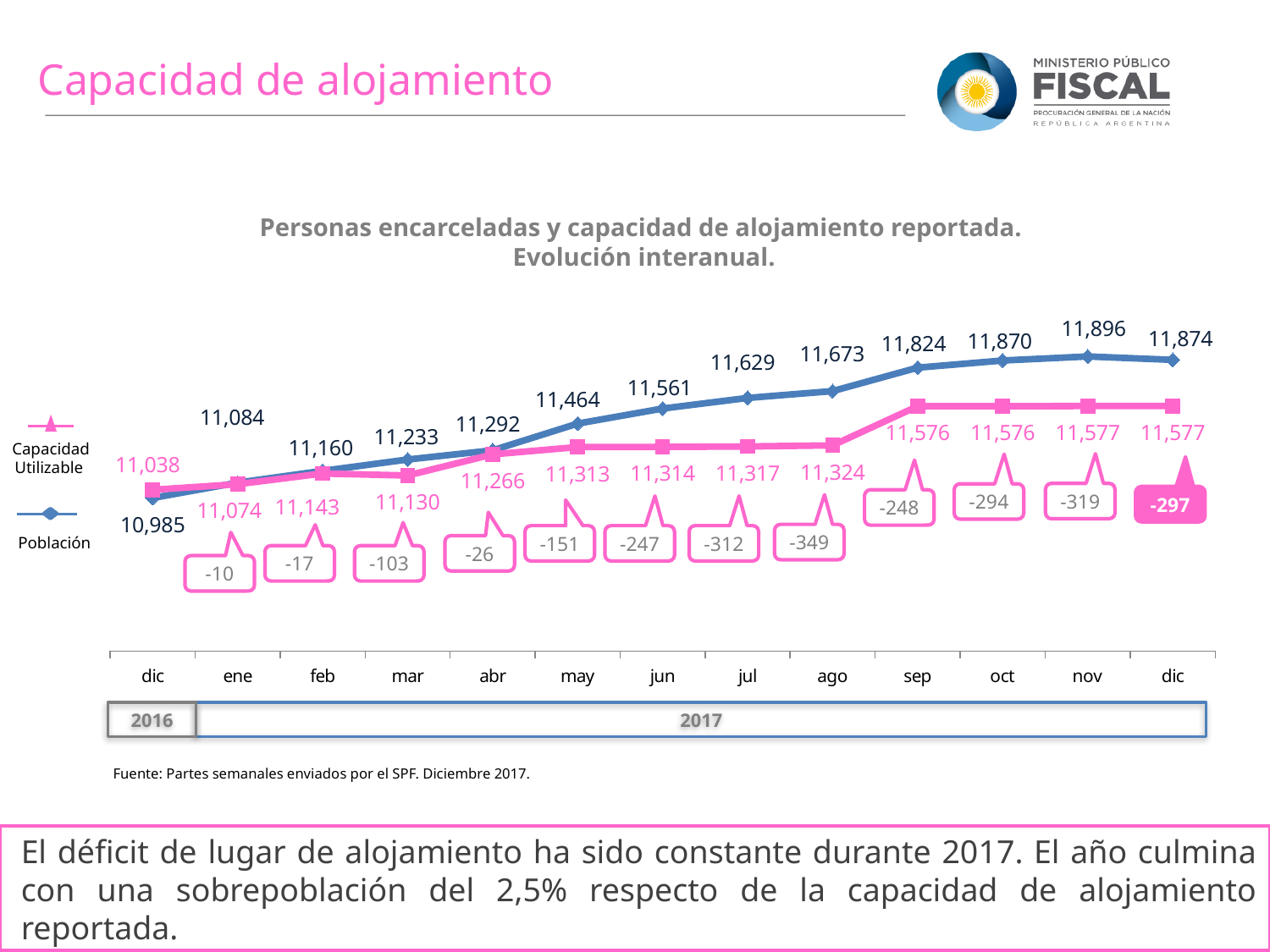
In which month is the Población series at its lowest value? dic 2016 What is the Capacidad Utilizable value for sep 2017? 11,576 What is the Capacidad Utilizable value for dic 2016? 11,038 How many months are plotted on the x axis? 13 What kind of chart is shown on the slide? Line chart Which is larger in dic 2016, Población or Capacidad Utilizable? Capacidad Utilizable What is the Población value for nov 2017? 11,896 How many series does the legend list? 2 Does the Población series generally rise or fall from dic 2016 to nov 2017? Rise What is the difference between Población and Capacidad Utilizable in ago 2017? 349 What is the Población value for may 2017? 11,464 In which month does the Población series reach its highest value? nov 2017